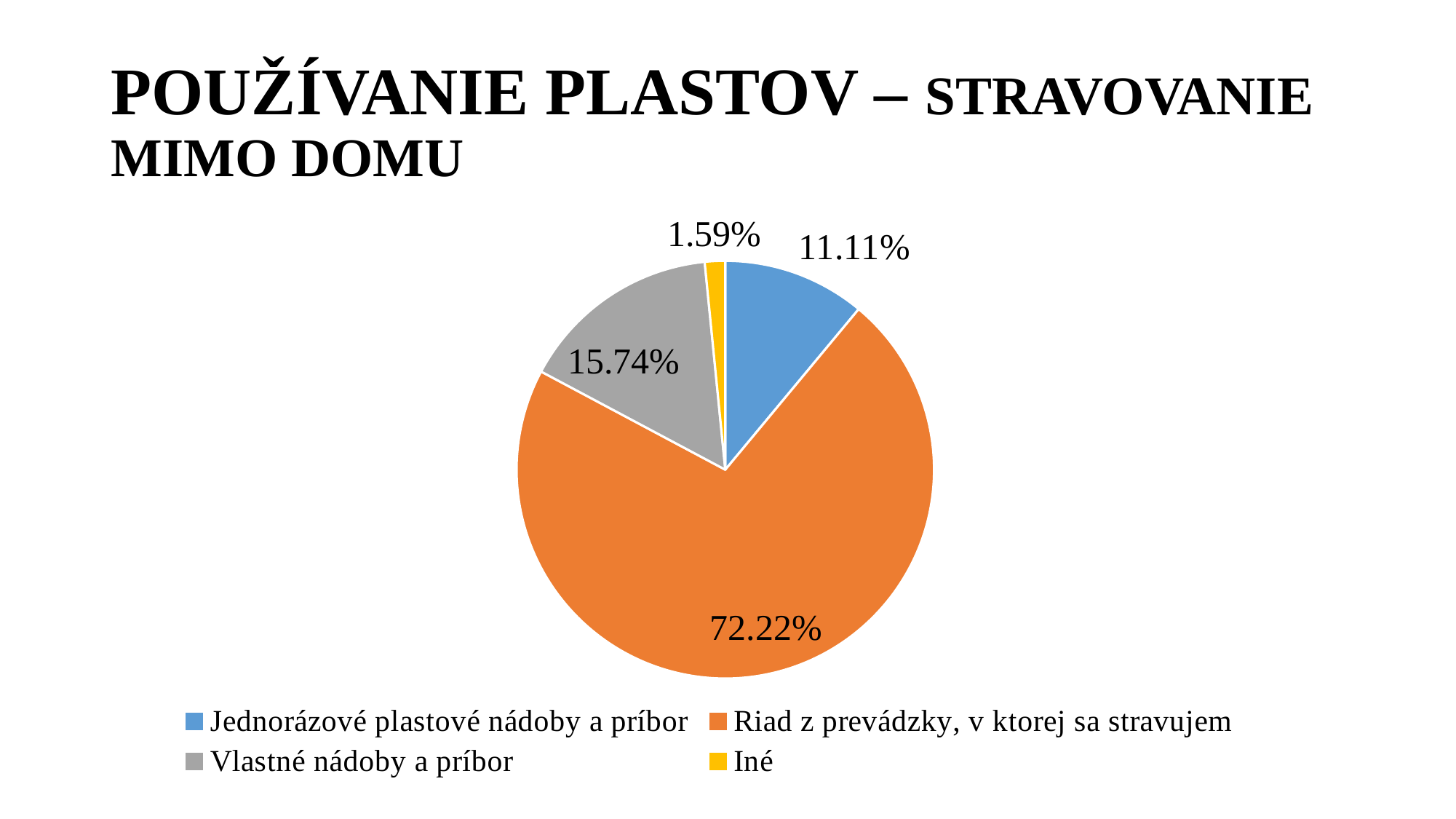
What colour is the slice for "Iné"? yellow How many categories does the pie chart have? 4 What share of the pie does "Jednorázové plastové nádoby a príbor" have? 11.11% Which is larger: the slice for "Vlastné nádoby a príbor" or the slice for "Jednorázové plastové nádoby a príbor"? Vlastné nádoby a príbor What share of the pie does "Iné" have? 1.59% What kind of chart is shown on the slide? pie chart Which category has the largest slice of the pie? Riad z prevádzky, v ktorej sa stravujem Which category has the smallest slice of the pie? Iné What is the title of the slide containing the chart? POUŽÍVANIE PLASTOV – STRAVOVANIE MIMO DOMU What share of the pie does "Vlastné nádoby a príbor" have? 15.74% What share of the pie does "Riad z prevádzky, v ktorej sa stravujem" have? 72.22% What is the difference in percentage points between "Vlastné nádoby a príbor" and "Jednorázové plastové nádoby a príbor"? 4.63